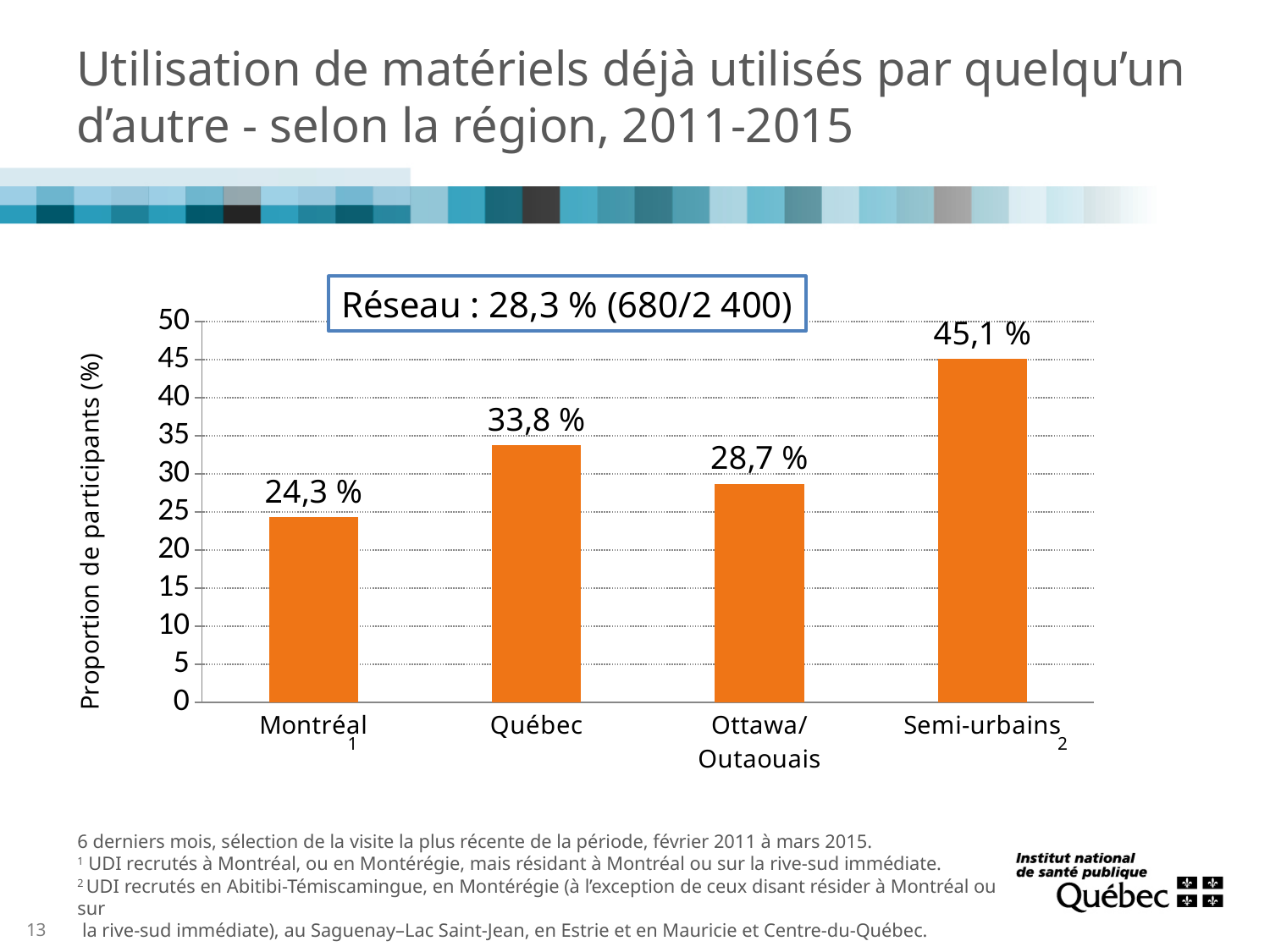
Which region has the lowest proportion of participants? Montréal What is the difference between the values for Semi-urbains and Montréal? 20,8 % What is the label of the vertical axis? Proportion de participants (%) Which is larger, the value for Québec or the value for Ottawa/Outaouais? Québec What is the value for Montréal? 24,3 % What kind of chart is shown on the slide? Bar chart What is the value for Ottawa/Outaouais? 28,7 % How many regions are shown on the chart? 4 What is the value for Semi-urbains? 45,1 % Which region has the highest proportion of participants? Semi-urbains What is the overall network (Réseau) value shown in the box above the chart? 28,3 % (680/2 400) What is the value for Québec? 33,8 %